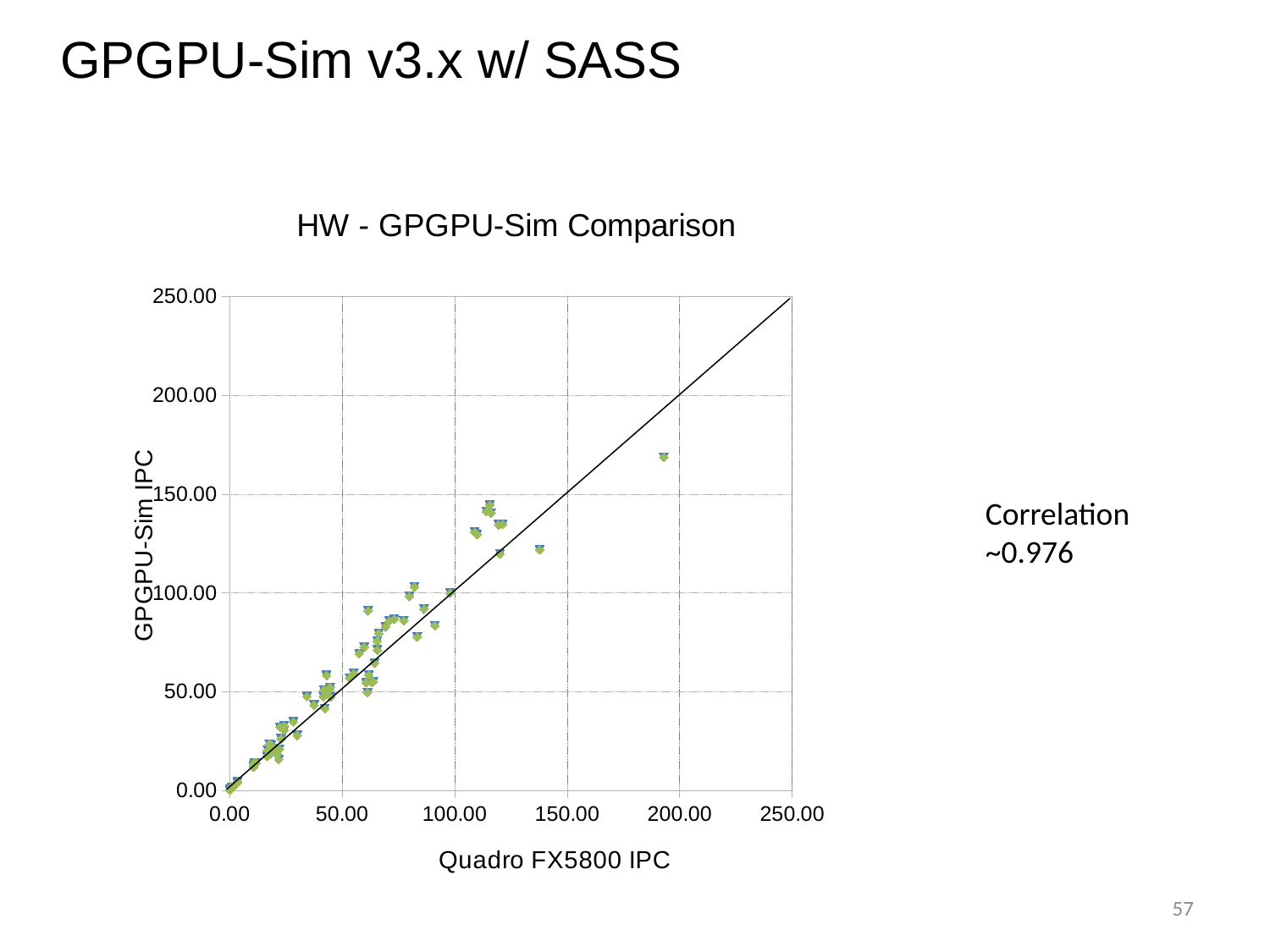
Is the Quadro FX5800 IPC of the rightmost point in the chart greater or less than 150.00? greater How many points in the chart have a GPGPU-Sim IPC above 200.00? 0 What is the label of the horizontal axis of the chart? Quadro FX5800 IPC As Quadro FX5800 IPC increases along the x axis, does GPGPU-Sim IPC generally rise or fall? Rise Is the Quadro FX5800 IPC of the rightmost point in the chart greater or less than 200.00? less How many points in the chart have a Quadro FX5800 IPC above 150.00? 1 What kind of chart is shown on the slide? Scatter chart Is the GPGPU-Sim IPC of the rightmost point in the chart greater or less than 150.00? greater What is the title of the chart? HW - GPGPU-Sim Comparison